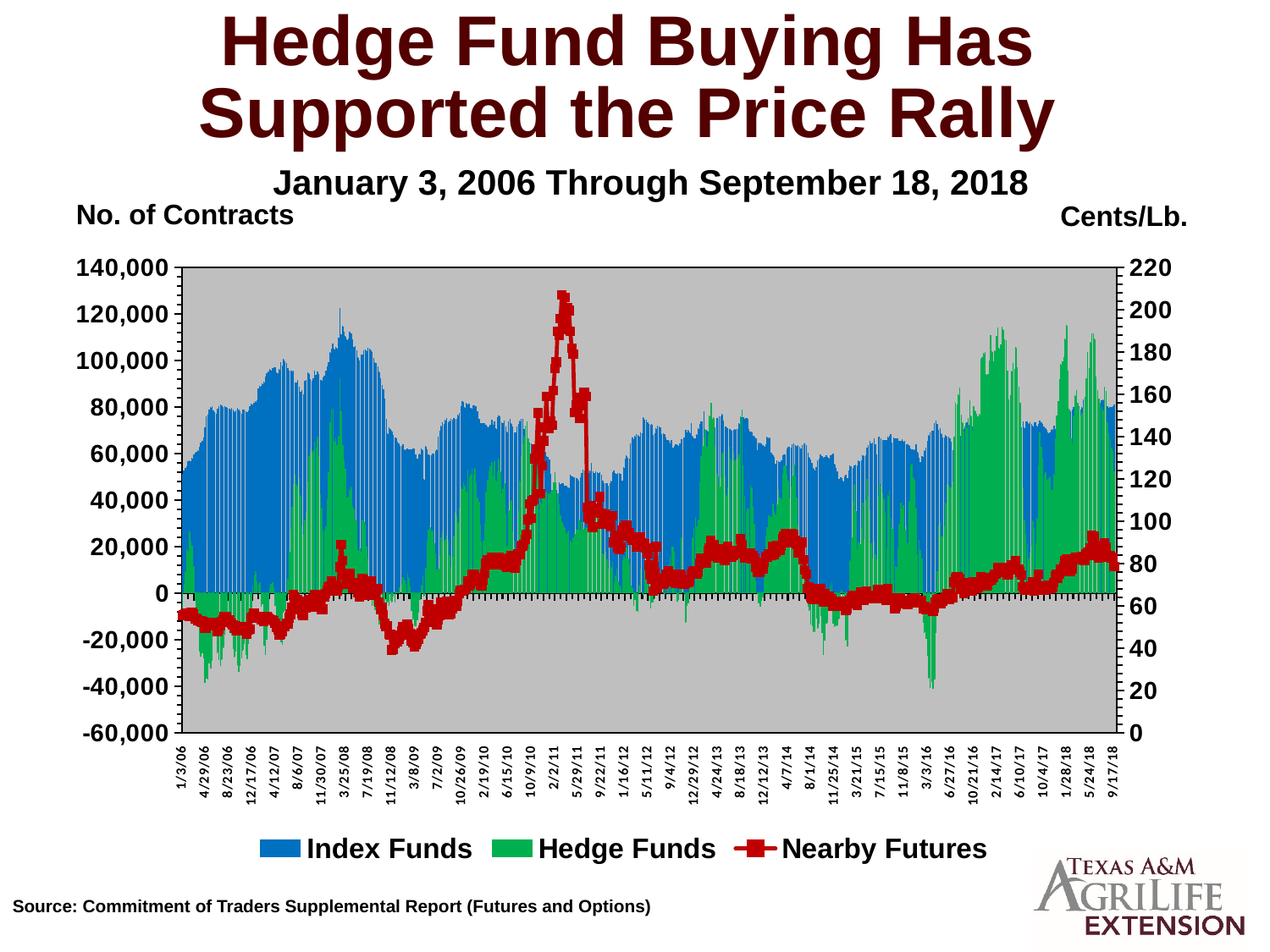
Which series is drawn as a red line with square markers? Nearby Futures Is the Nearby Futures value around 11/12/08 greater or less than 60 cents/lb? less How many series does the legend list? 3 Is the Index Funds value around 3/25/08 greater or less than 100,000 contracts? greater What is the label of the left vertical axis? No. of Contracts Is the Nearby Futures value at 1/3/06 greater or less than 80 cents/lb? less What kind of chart is shown on the slide? A combined bar and line chart Does the Nearby Futures line rise or fall between 2/2/11 and 9/22/11? fall Around 3/25/08, which series has the larger number of contracts, Index Funds or Hedge Funds? Index Funds Does the Nearby Futures line rise or fall between 10/9/10 and 2/2/11? rise